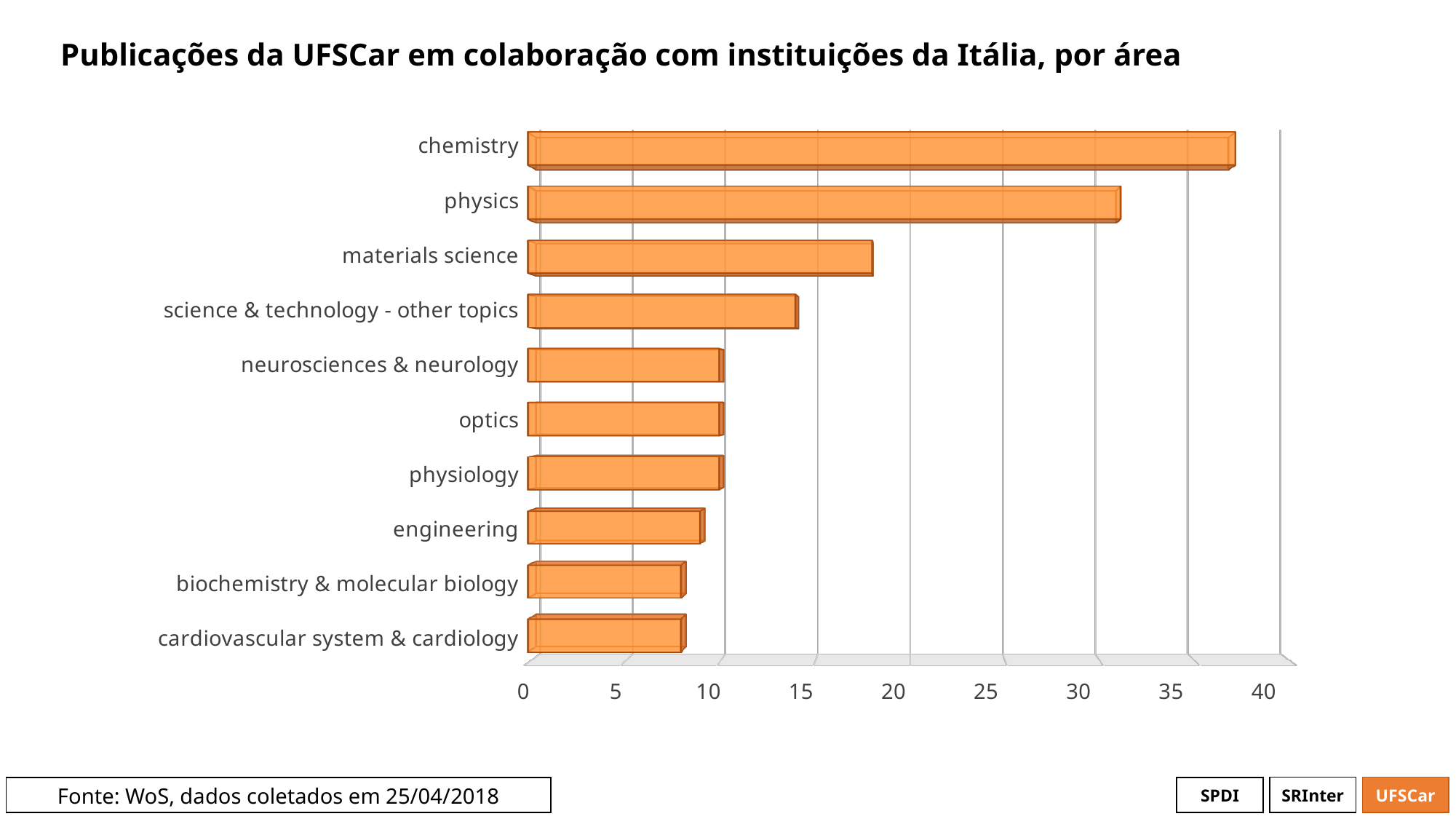
Is the value for cardiovascular system & cardiology greater or less than 10? less Which has more publications, chemistry or physics? chemistry What is the title of the chart? Publicações da UFSCar em colaboração com instituições da Itália, por área Which area has the highest number of publications? chemistry Is the value for science & technology - other topics greater or less than 10? greater How many areas (categories) are shown in the chart? 10 Is the value for physics greater or less than 30? greater What kind of chart is shown on the slide? bar chart Which has more publications, materials science or science & technology - other topics? materials science